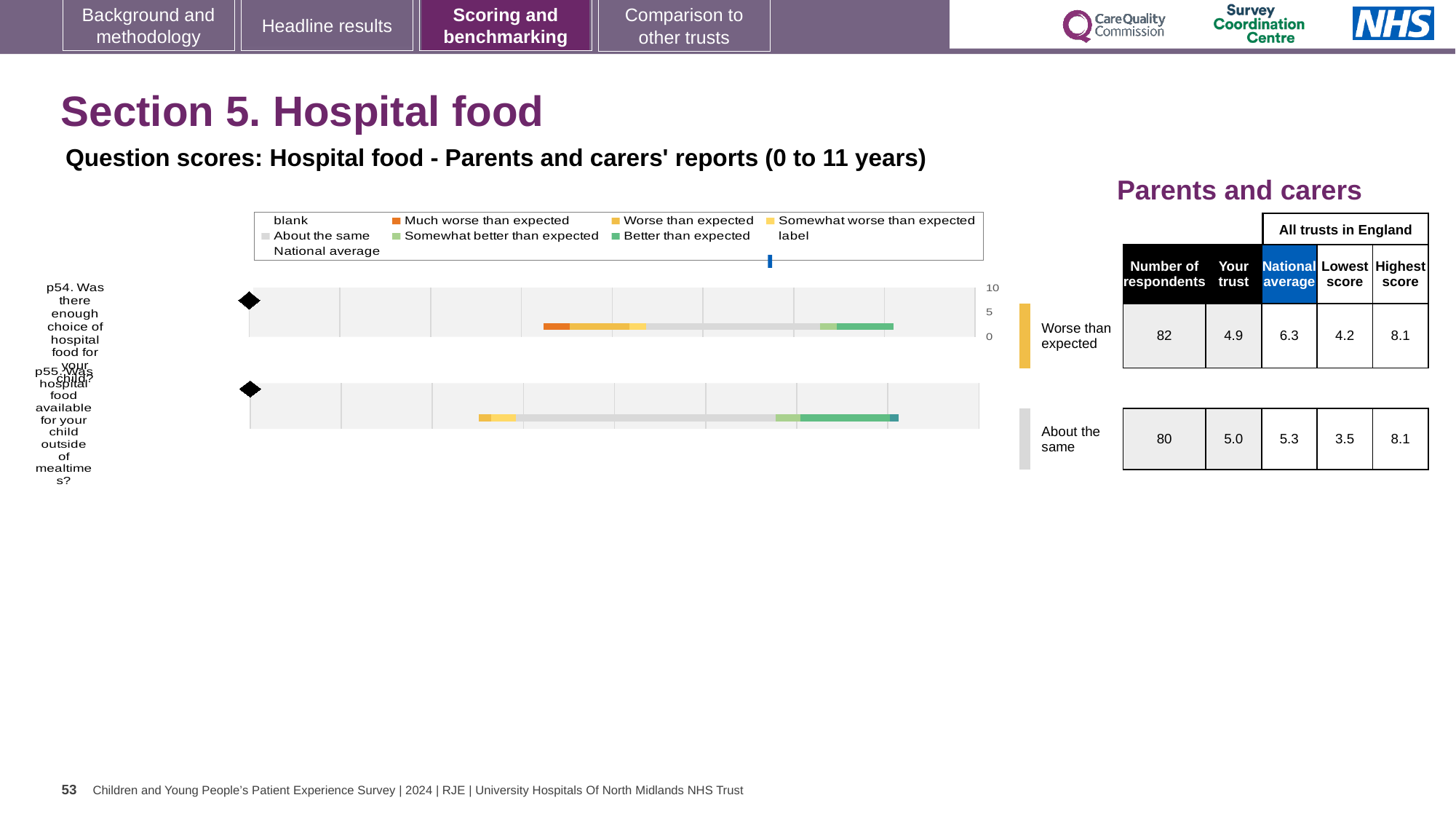
In the table beside the chart, what is the 'Your trust' score for the 'Worse than expected' row (p54)? 4.9 What is the highest tick value shown on the chart's axis? 10 How many survey questions (categories) are plotted in the chart? 2 What kind of chart is shown on the slide? bar chart In the table beside the chart, what is the national average for the 'About the same' row (p55)? 5.3 What colour does the legend use for 'Much worse than expected'? orange In the table beside the chart, what is the difference between the national average and the 'Your trust' score for the 'Worse than expected' row? 1.4 In the table beside the chart, which row has the higher 'Your trust' score: 'Worse than expected' or 'About the same'? About the same In the table beside the chart, how many respondents answered the 'Worse than expected' question (p54)? 82 What colour does the legend use for 'National average'? blue In the table beside the chart, what is the highest score for the 'About the same' row (p55)? 8.1 How many entries does the chart's legend list? 9